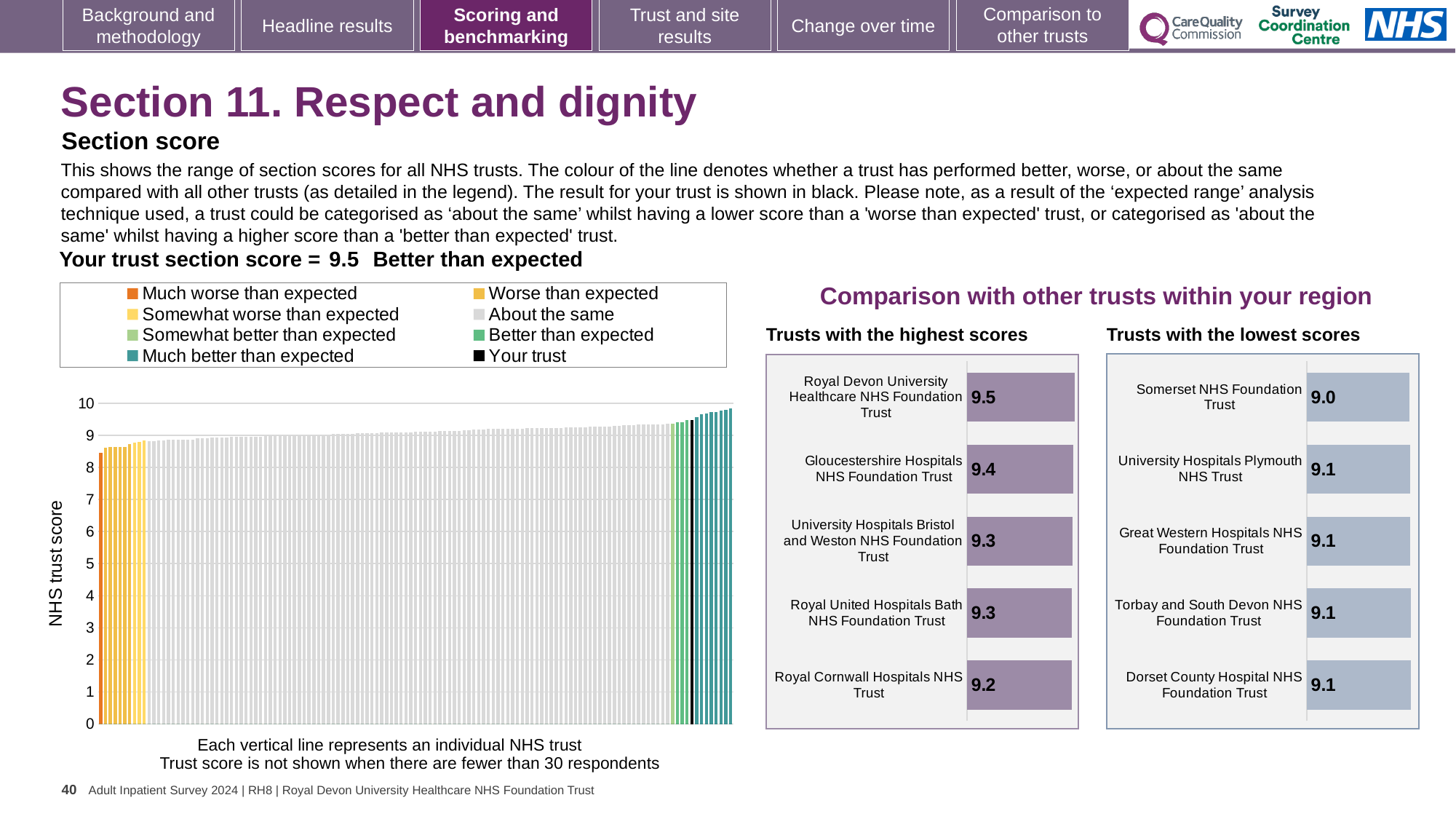
In the 'Trusts with the highest scores' chart, what is the score for Gloucestershire Hospitals NHS Foundation Trust? 9.4 In the 'Trusts with the lowest scores' chart, what is the score for Dorset County Hospital NHS Foundation Trust? 9.1 In the 'Trusts with the lowest scores' chart, what is the score for Somerset NHS Foundation Trust? 9.0 In the 'Trusts with the highest scores' chart, what is the score for Royal Cornwall Hospitals NHS Trust? 9.2 How many entries does the legend above the large 'NHS trust score' chart list? 8 In the 'Trusts with the lowest scores' chart, which trust has the lowest score? Somerset NHS Foundation Trust In the large 'NHS trust score' chart on the left, do the values rise or fall from left to right? Rise In the 'Trusts with the highest scores' chart, how many trusts are listed? 5 In the 'Trusts with the lowest scores' chart, which is larger: the score for Somerset NHS Foundation Trust or the score for University Hospitals Plymouth NHS Trust? University Hospitals Plymouth NHS Trust In the 'Trusts with the highest scores' chart, what is the difference between the scores of Royal Devon University Healthcare NHS Foundation Trust and Royal Cornwall Hospitals NHS Trust? 0.3 What kind of chart is the large 'NHS trust score' chart on the left of the slide? Bar chart In the 'Trusts with the highest scores' chart, which trust has the highest score? Royal Devon University Healthcare NHS Foundation Trust